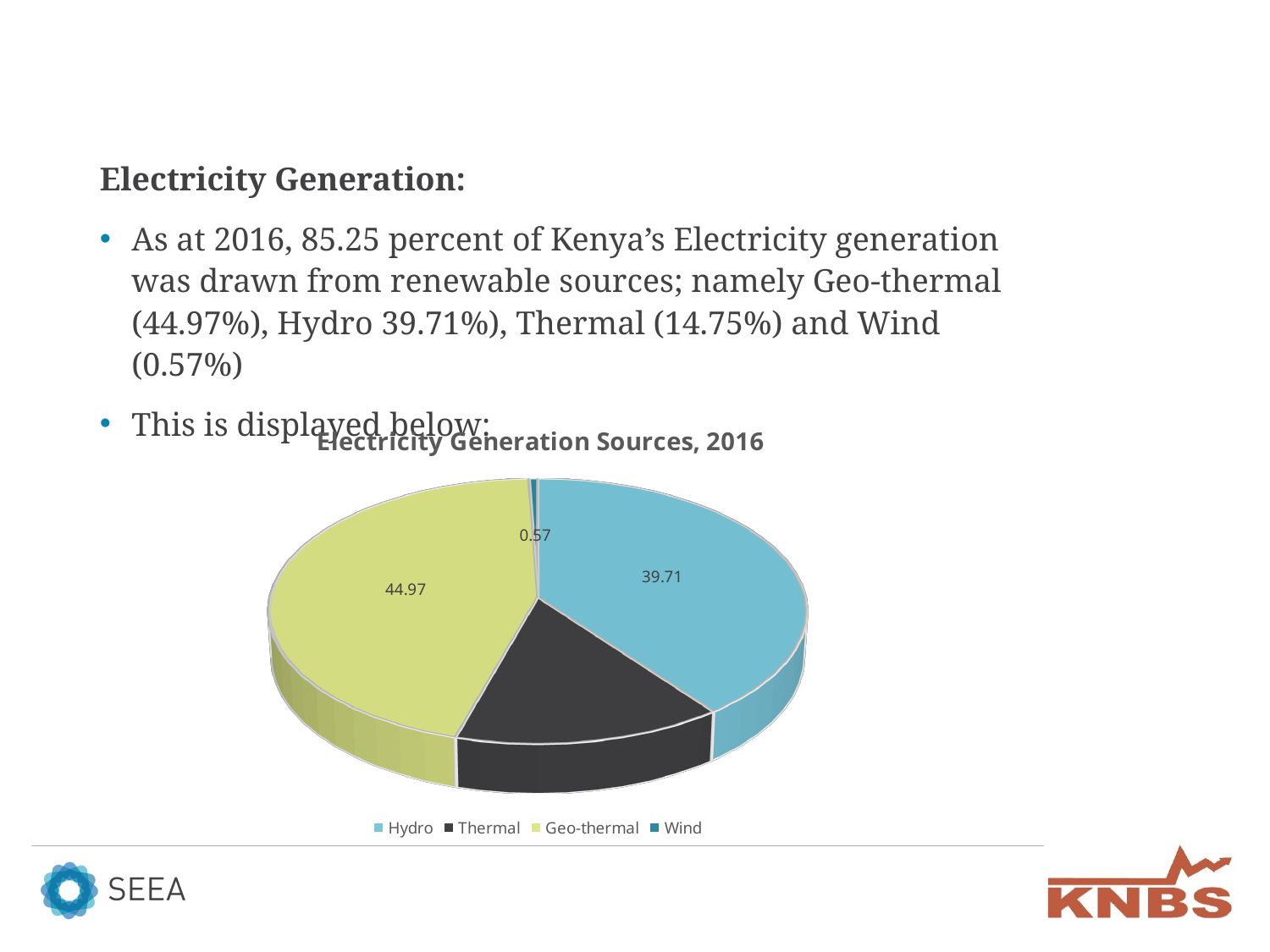
How many entries does the chart legend list? 4 What is the difference between the Geo-thermal value and the Hydro value? 5.26 Which is larger, the Hydro slice or the Thermal slice? Hydro Which colour represents Thermal in the pie chart? Dark grey/black What is the title of the chart? Electricity Generation Sources, 2016 Which electricity generation source has the smallest slice of the pie? Wind Which electricity generation source has the largest slice of the pie? Geo-thermal What value is shown for Hydro in the pie chart? 39.71 What type of chart is shown on the slide? Pie chart What value is shown for Wind in the pie chart? 0.57 What value is shown for Geo-thermal in the pie chart? 44.97 How many categories are shown in the pie chart? 4